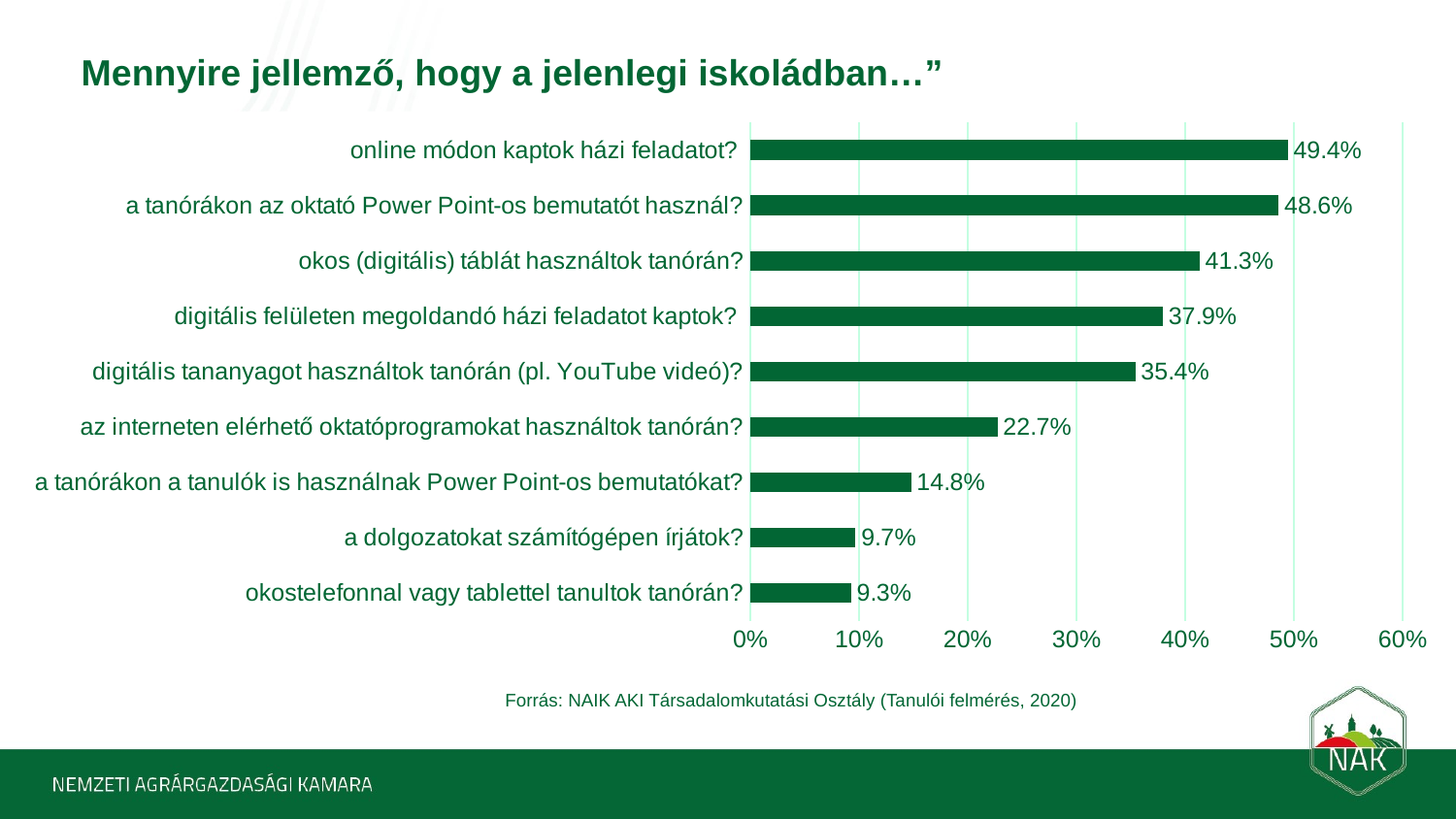
Which category has the highest value? online módon kaptok házi feladatot? Which category has the lowest value? okostelefonnal vagy tablettel tanultok tanórán? What is the maximum value shown on the x axis? 60% What is the value for "online módon kaptok házi feladatot?"? 49.4% What is the difference between the values for "digitális felületen megoldandó házi feladatot kaptok?" and "digitális tananyagot használtok tanórán (pl. YouTube videó)?"? 2.5% What is the value for "a dolgozatokat számítógépen írjátok?"? 9.7% What kind of chart is shown on the slide? bar chart What is the value for "okos (digitális) táblát használtok tanórán?"? 41.3% Is the value for "a tanórákon az oktató Power Point-os bemutatót használ?" greater or less than 40%? greater How many categories are shown in the chart? 9 What is the source cited below the chart? NAIK AKI Társadalomkutatási Osztály (Tanulói felmérés, 2020) Which is larger: the value for "az interneten elérhető oktatóprogramokat használtok tanórán?" or for "a tanórákon a tanulók is használnak Power Point-os bemutatókat?"? az interneten elérhető oktatóprogramokat használtok tanórán?